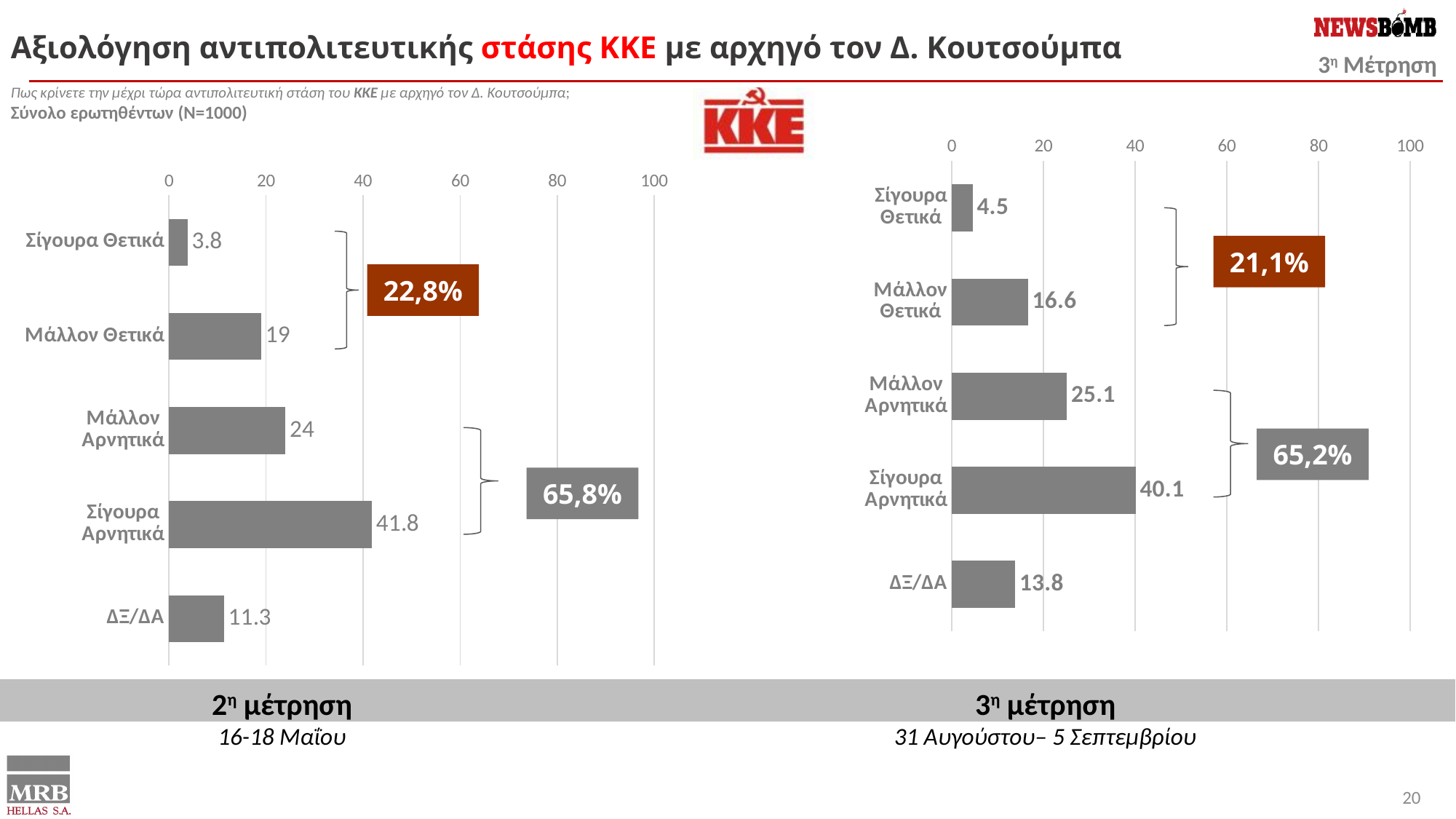
In the 3η μέτρηση chart on the right, what combined percentage is shown in the orange box for the positive categories? 21,1% Which is larger: ΔΞ/ΔΑ in the 2η μέτρηση chart or ΔΞ/ΔΑ in the 3η μέτρηση chart? 3η μέτρηση In the 2η μέτρηση chart on the left, what is the value for Σίγουρα Αρνητικά? 41.8 In the 2η μέτρηση chart on the left, is the value for Σίγουρα Αρνητικά greater or less than 40? greater In the 3η μέτρηση chart on the right, what is the value for Μάλλον Θετικά? 16.6 What type of chart is the 2η μέτρηση chart on the left? bar chart In the 2η μέτρηση chart on the left, what is the difference between Μάλλον Αρνητικά and Μάλλον Θετικά? 5 In the 3η μέτρηση chart on the right, which category has the lowest value? Σίγουρα Θετικά In the 3η μέτρηση chart on the right, what is the value for ΔΞ/ΔΑ? 13.8 In the 3η μέτρηση chart on the right, what is the difference between Σίγουρα Αρνητικά and Μάλλον Αρνητικά? 15 In the 2η μέτρηση chart on the left, which category has the highest value? Σίγουρα Αρνητικά How many categories are shown in the 3η μέτρηση chart on the right? 5